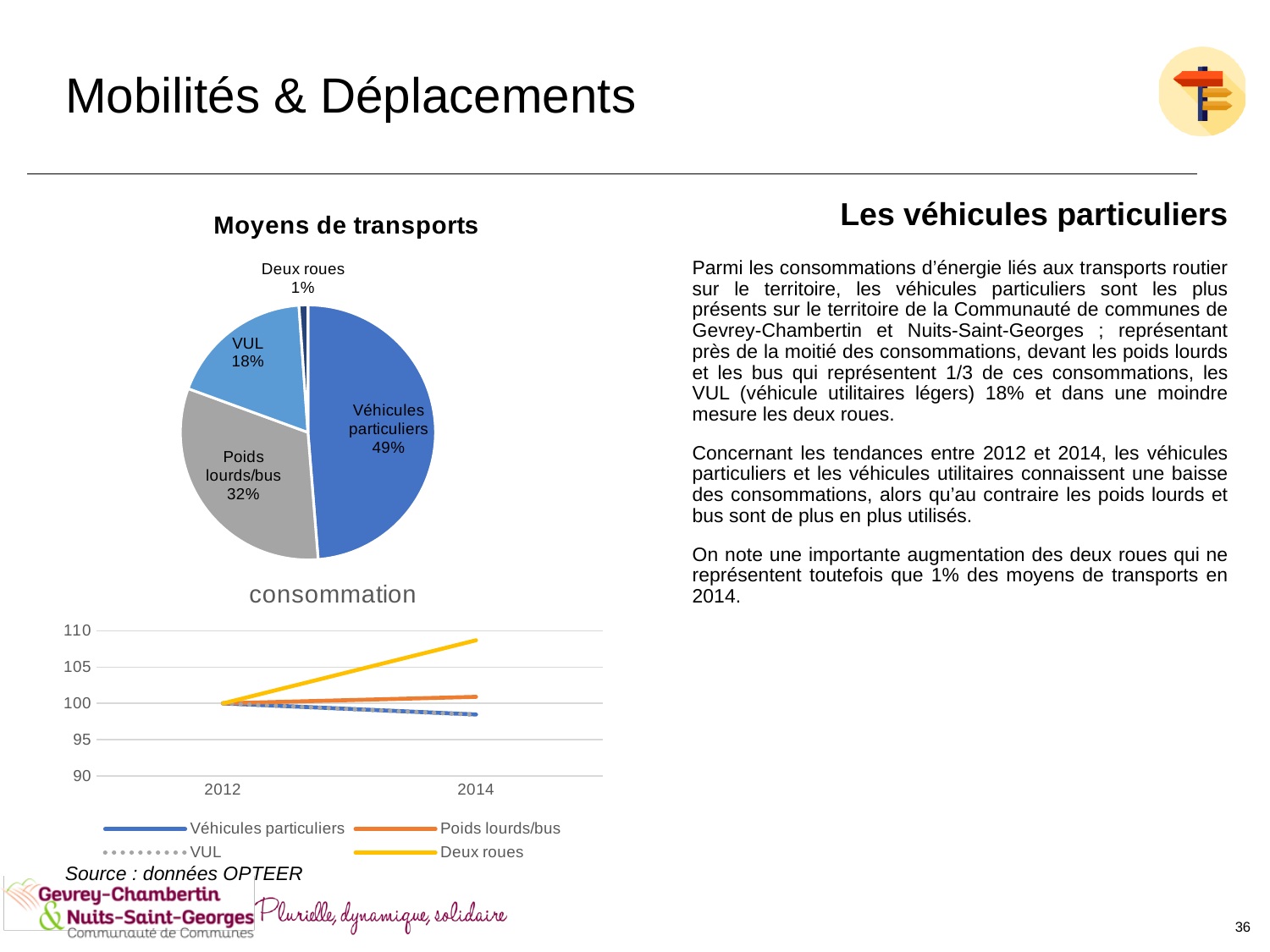
In the 'consommation' chart, does the Véhicules particuliers line rise or fall from 2012 to 2014? Fall In the 'Moyens de transports' pie chart, what is the difference in percentage points between Véhicules particuliers and Poids lourds/bus? 17 What kind of chart is the 'Moyens de transports' chart? Pie chart What kind of chart is the 'consommation' chart? Line chart How many series does the legend of the 'consommation' chart list? 4 In the 'Moyens de transports' pie chart, which category has the largest share? Véhicules particuliers How many slices does the 'Moyens de transports' pie chart have? 4 In the 'Moyens de transports' pie chart, what share is shown for Véhicules particuliers? 49% In the 'Moyens de transports' pie chart, which category has the smallest share? Deux roues In the 'Moyens de transports' pie chart, what share is shown for Poids lourds/bus? 32% In the 'Moyens de transports' pie chart, what share is shown for VUL? 18% In the 'consommation' chart, is the value for Deux roues in 2014 greater or less than 105? greater